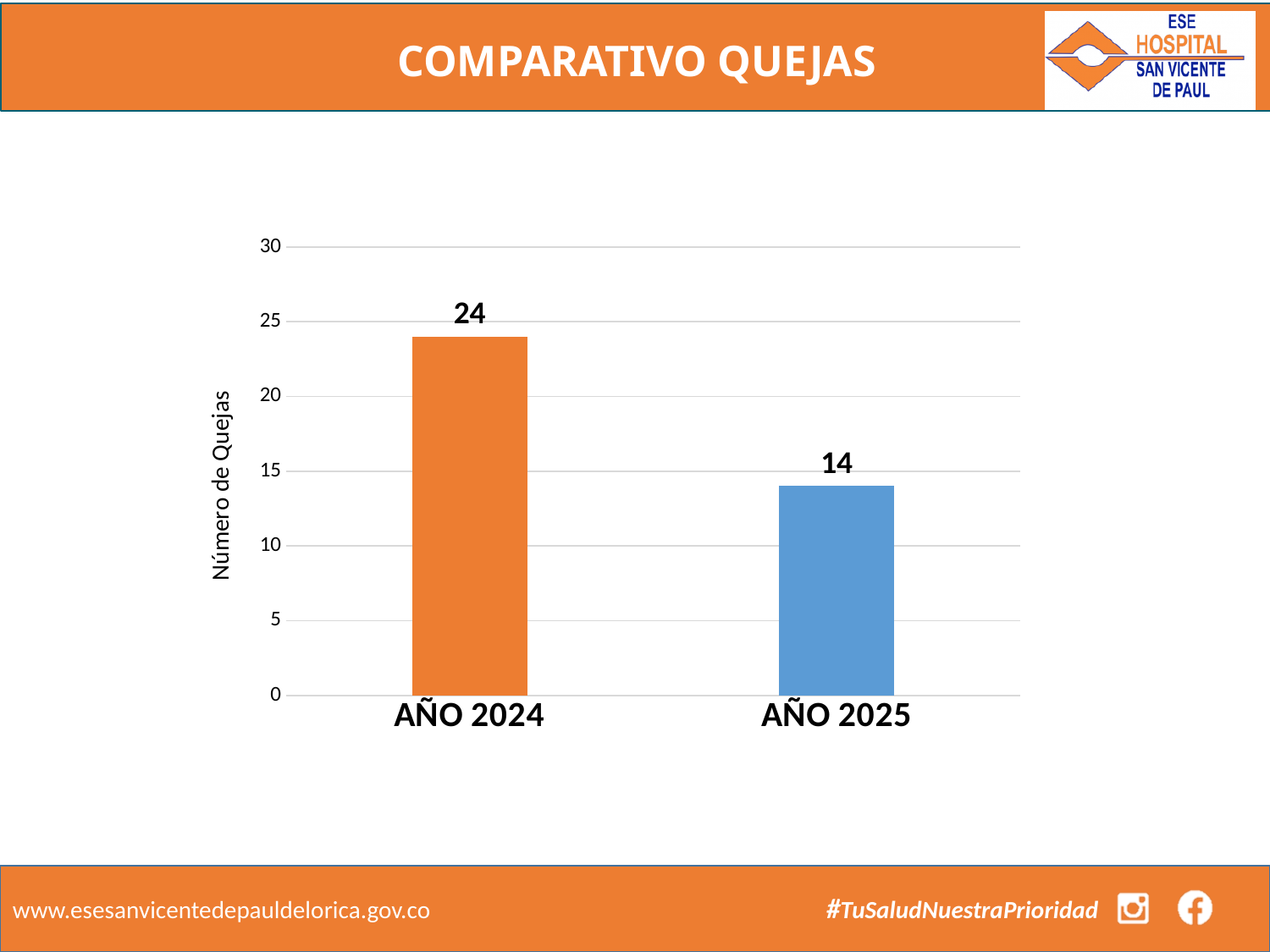
How many categories are shown on the x axis? 2 What is the value for AÑO 2024? 24 What is the value for AÑO 2025? 14 Which year has the lowest number of quejas? AÑO 2025 What is the label of the vertical axis? Número de Quejas Is the value for AÑO 2024 greater or less than 20? greater Is the value for AÑO 2025 greater or less than 15? less Do the values rise or fall from AÑO 2024 to AÑO 2025? fall Which is larger, the value for AÑO 2024 or AÑO 2025? AÑO 2024 What kind of chart is shown on the slide? bar chart What is the difference between the values for AÑO 2024 and AÑO 2025? 10 Which year has the highest number of quejas? AÑO 2024